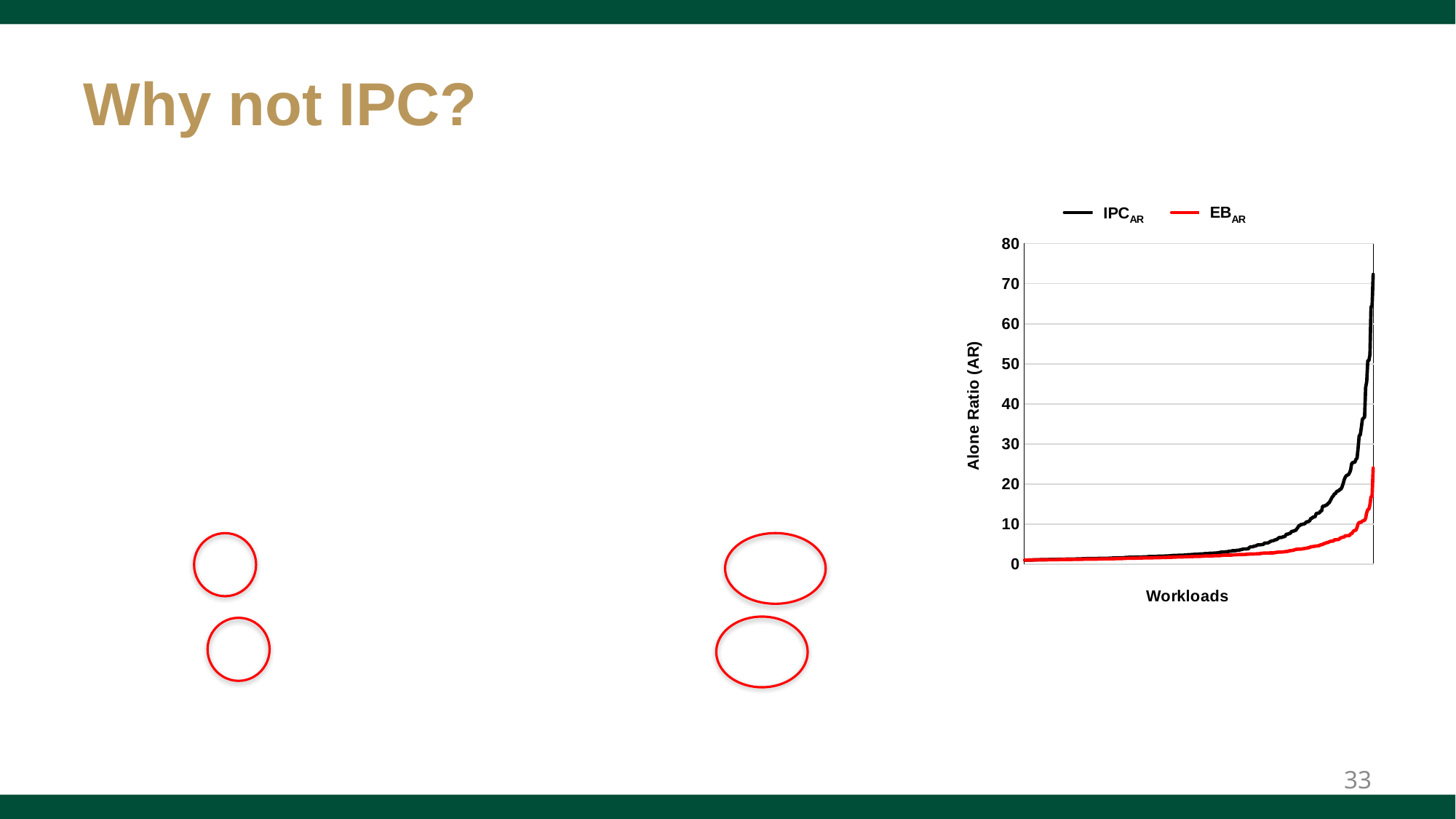
Is the highest value of the EB_AR series greater or less than 30? less Which series is drawn in red? EB_AR How many series does the legend list? 2 What is the title of the y axis? Alone Ratio (AR) Which series reaches the higher value at the right end of the x axis, IPC_AR or EB_AR? IPC_AR Do the values of the EB_AR series rise or fall along the x axis? rise What kind of chart is shown on the slide? line chart Is the highest value of the EB_AR series greater or less than 10? greater Do the values of the IPC_AR series rise or fall along the x axis? rise What is the highest tick value shown on the y axis? 80 Is the highest value of the IPC_AR series greater or less than 60? greater